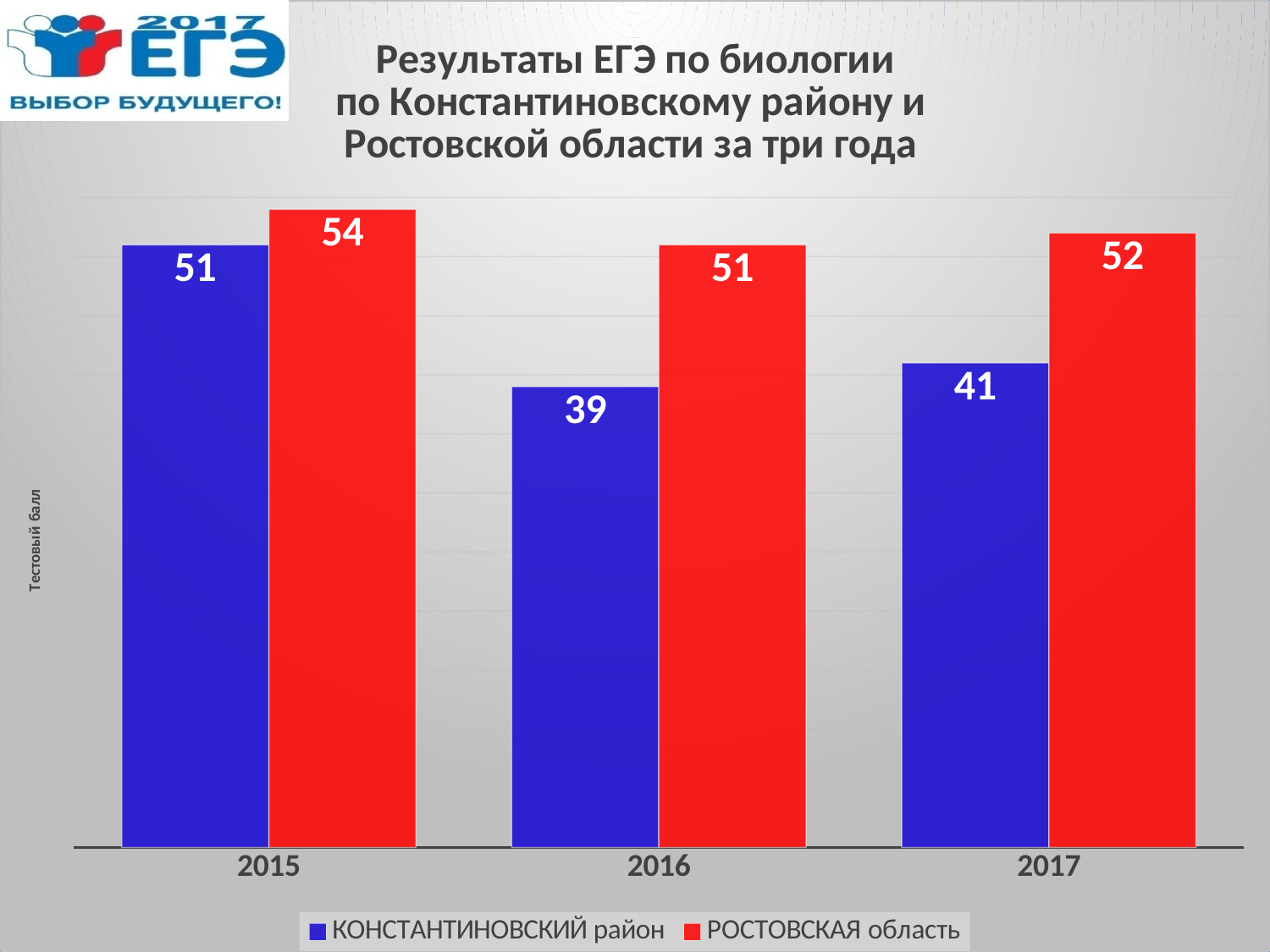
What was the test score for Константиновский район in 2017? 41 What is the difference between the Ростовская область and Константиновский район scores in 2017? 11 Which had the higher score in 2015, Константиновский район or Ростовская область? Ростовская область What kind of chart is shown on the slide? bar chart In which year did Константиновский район have its lowest test score? 2016 What was the test score for Константиновский район in 2016? 39 What was the test score for Ростовская область in 2015? 54 How many series does the legend list? 2 How many years are shown on the x axis? 3 In which year did Ростовская область have its highest test score? 2015 Which colour represents Ростовская область in the chart? red What is the difference between the Ростовская область and Константиновский район scores in 2016? 12